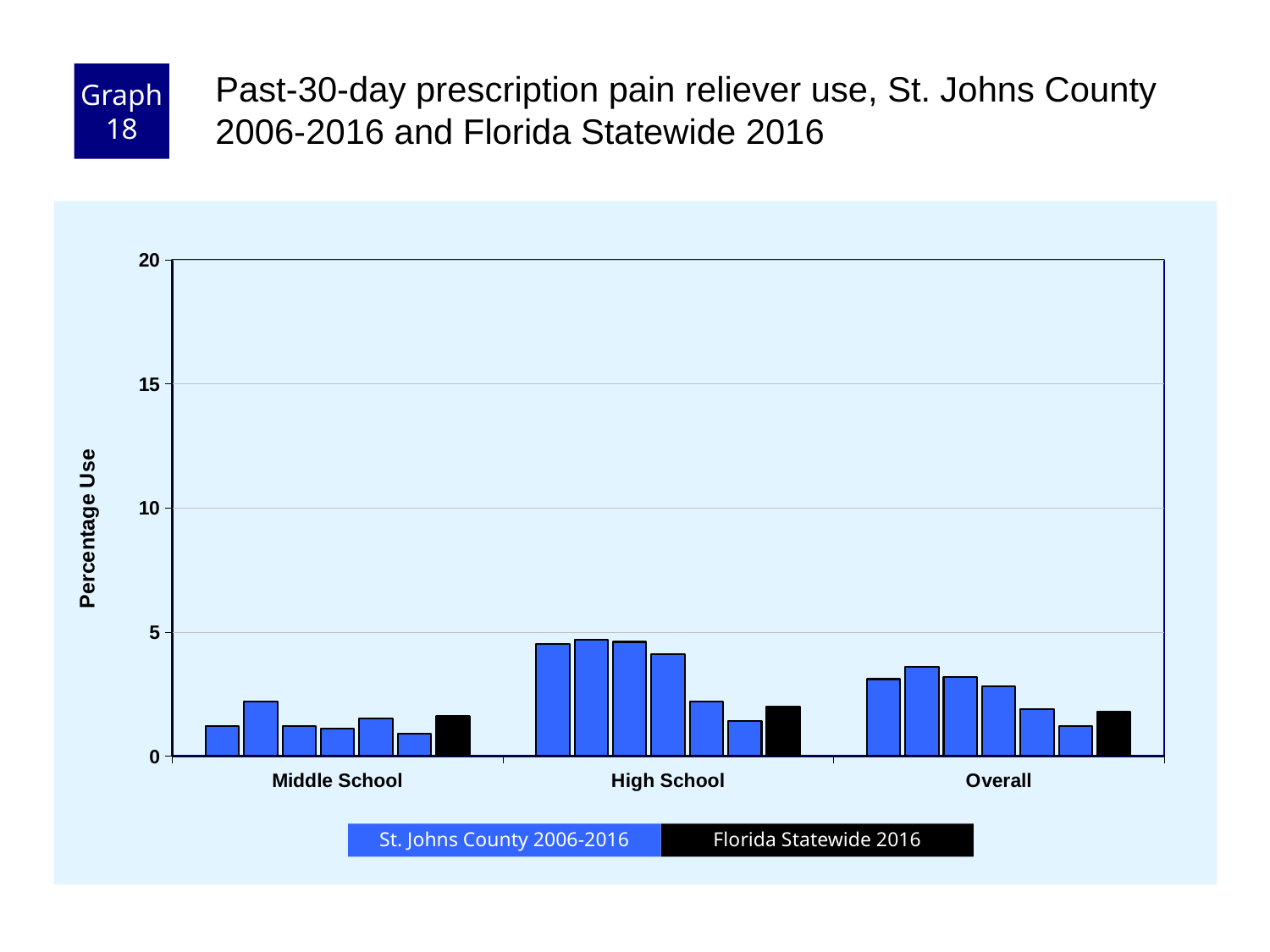
How many series does the legend list? 2 What kind of chart is shown on the slide? bar chart Which category has the tallest bars overall? High School Which series is shown in black in the legend? Florida Statewide 2016 How many categories are shown on the x axis? 3 Which category has the shortest bars overall? Middle School What is the label on the y axis? Percentage Use Is the Florida Statewide 2016 value for High School larger or smaller than the Florida Statewide 2016 value for Middle School? larger Is the Florida Statewide 2016 value for High School greater or less than 5? less Are all the St. Johns County 2006-2016 bars for High School greater or less than 5? less Is the Florida Statewide 2016 value for Middle School greater or less than 5? less